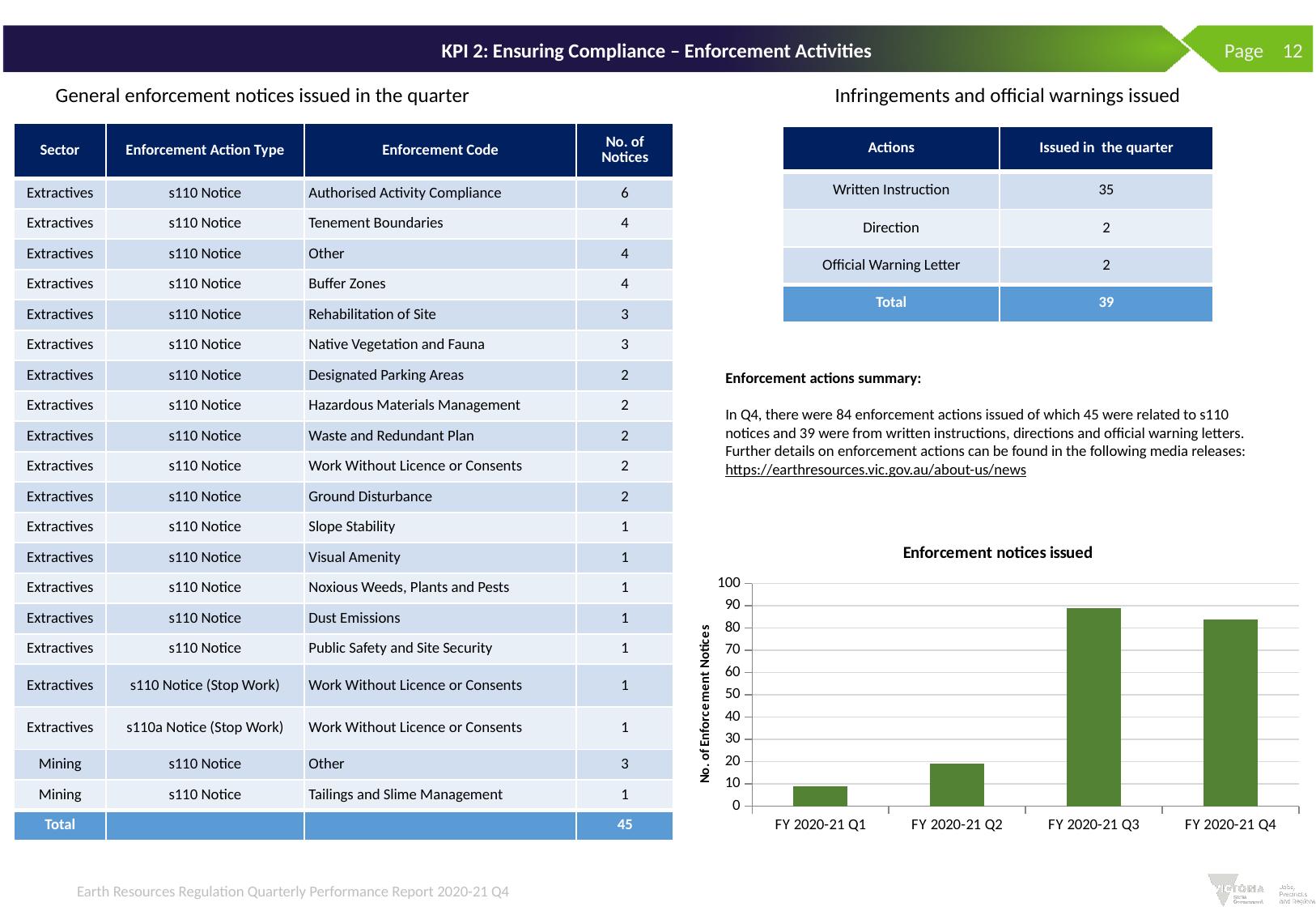
On the 'Enforcement notices issued' chart, do the values rise or fall from FY 2020-21 Q1 to FY 2020-21 Q3? rise On the 'Enforcement notices issued' chart, which quarter has the highest number of enforcement notices? FY 2020-21 Q3 On the 'Enforcement notices issued' chart, is the value for FY 2020-21 Q3 greater or less than 80? greater On the 'Enforcement notices issued' chart, is the value for FY 2020-21 Q4 greater or less than 90? less What is the y-axis label on the 'Enforcement notices issued' chart? No. of Enforcement Notices On the 'Enforcement notices issued' chart, is the value for FY 2020-21 Q2 greater or less than 10? greater How many quarters are plotted on the 'Enforcement notices issued' chart? 4 What is the title of the bar chart on the slide? Enforcement notices issued What kind of chart is the 'Enforcement notices issued' chart? bar chart On the 'Enforcement notices issued' chart, which quarter has the lowest number of enforcement notices? FY 2020-21 Q1 On the 'Enforcement notices issued' chart, which is larger: the value for FY 2020-21 Q2 or FY 2020-21 Q4? FY 2020-21 Q4